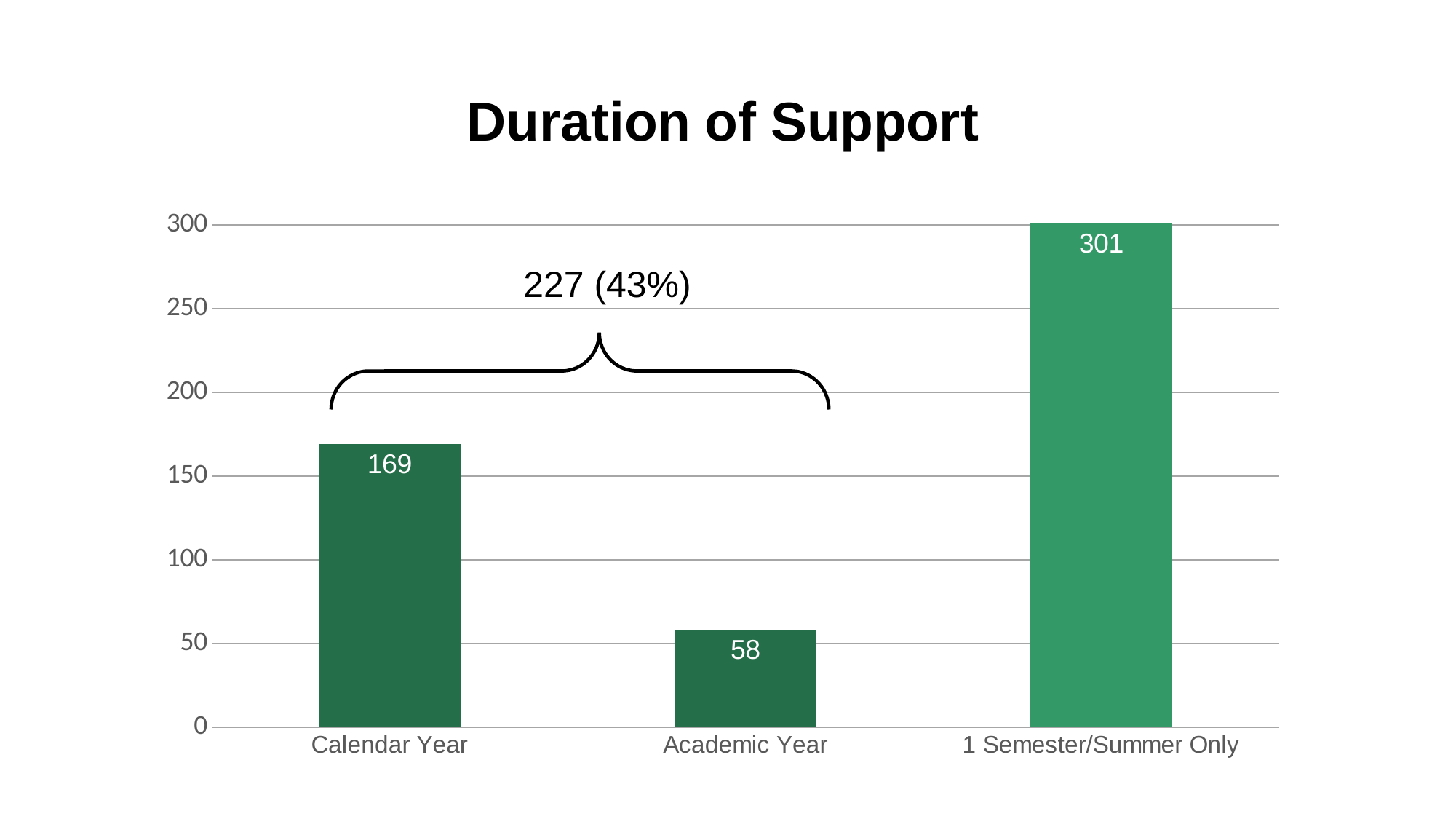
What is the value for 1 Semester/Summer Only? 301 What is the title of the chart? Duration of Support Which category has the lowest value? Academic Year What is the value for Calendar Year? 169 Which is larger, the value for Calendar Year or the value for Academic Year? Calendar Year How many categories are shown on the x axis? 3 Is the value for Academic Year greater or less than 100? less What is the difference between the values for 1 Semester/Summer Only and Calendar Year? 132 What kind of chart is shown on the slide? bar chart Which category has the highest value? 1 Semester/Summer Only What is the value for Academic Year? 58 What is the difference between the values for Calendar Year and Academic Year? 111